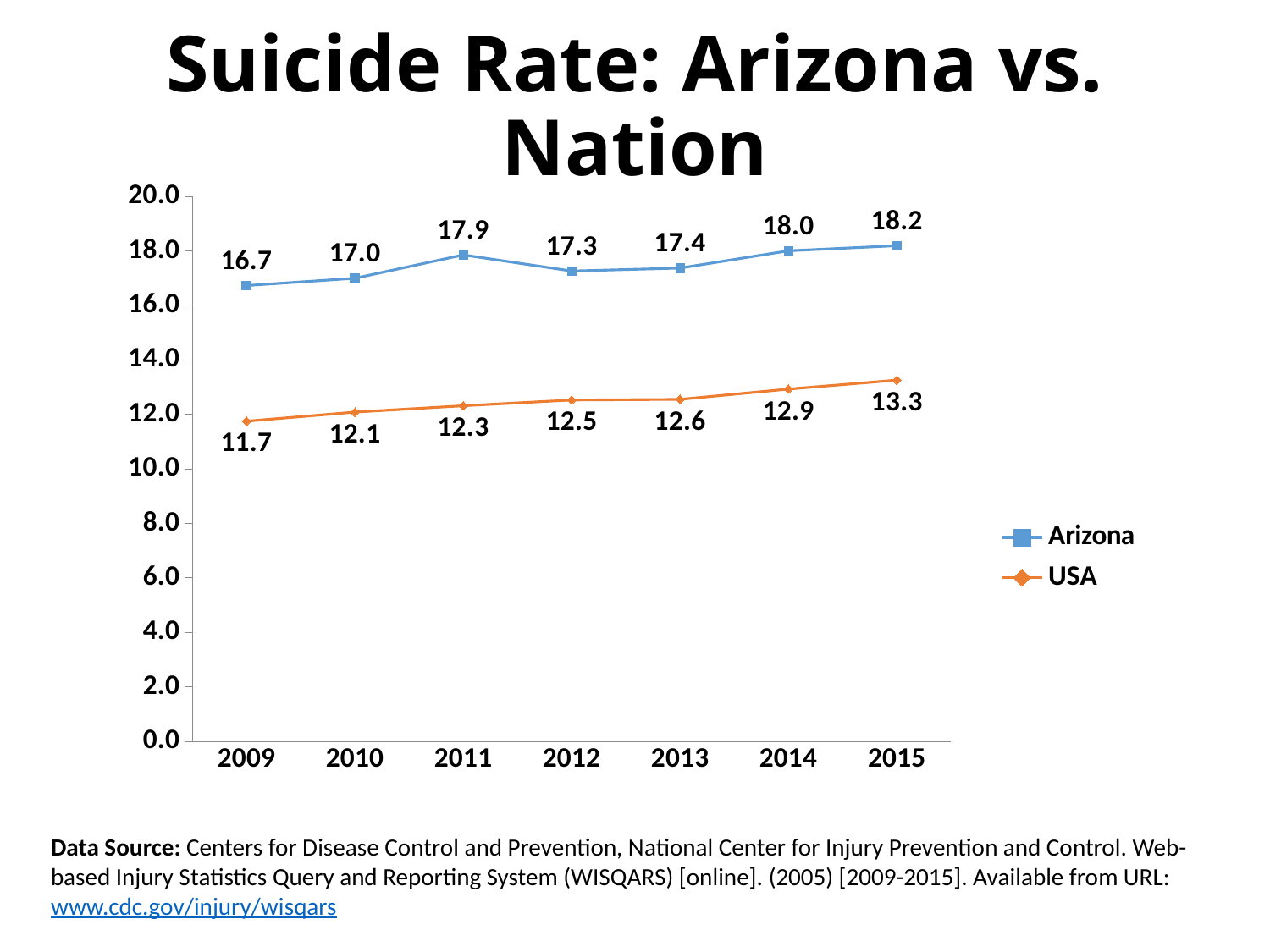
By how much did the Arizona suicide rate change from 2009 to 2015? 1.5 Does the USA suicide rate rise or fall from 2009 to 2015? Rise What type of chart is shown on the slide? Line chart Is the USA suicide rate in 2013 greater or less than 14.0? less Which had a higher suicide rate in 2012, Arizona or the USA? Arizona In which year was the USA suicide rate lowest? 2009 How many years are shown on the x axis? 7 What was the suicide rate for the USA in 2014? 12.9 In which year was the Arizona suicide rate highest? 2015 What is the difference between the Arizona and USA suicide rates in 2015? 4.9 What was the suicide rate for Arizona in 2011? 17.9 How many series does the legend list? 2